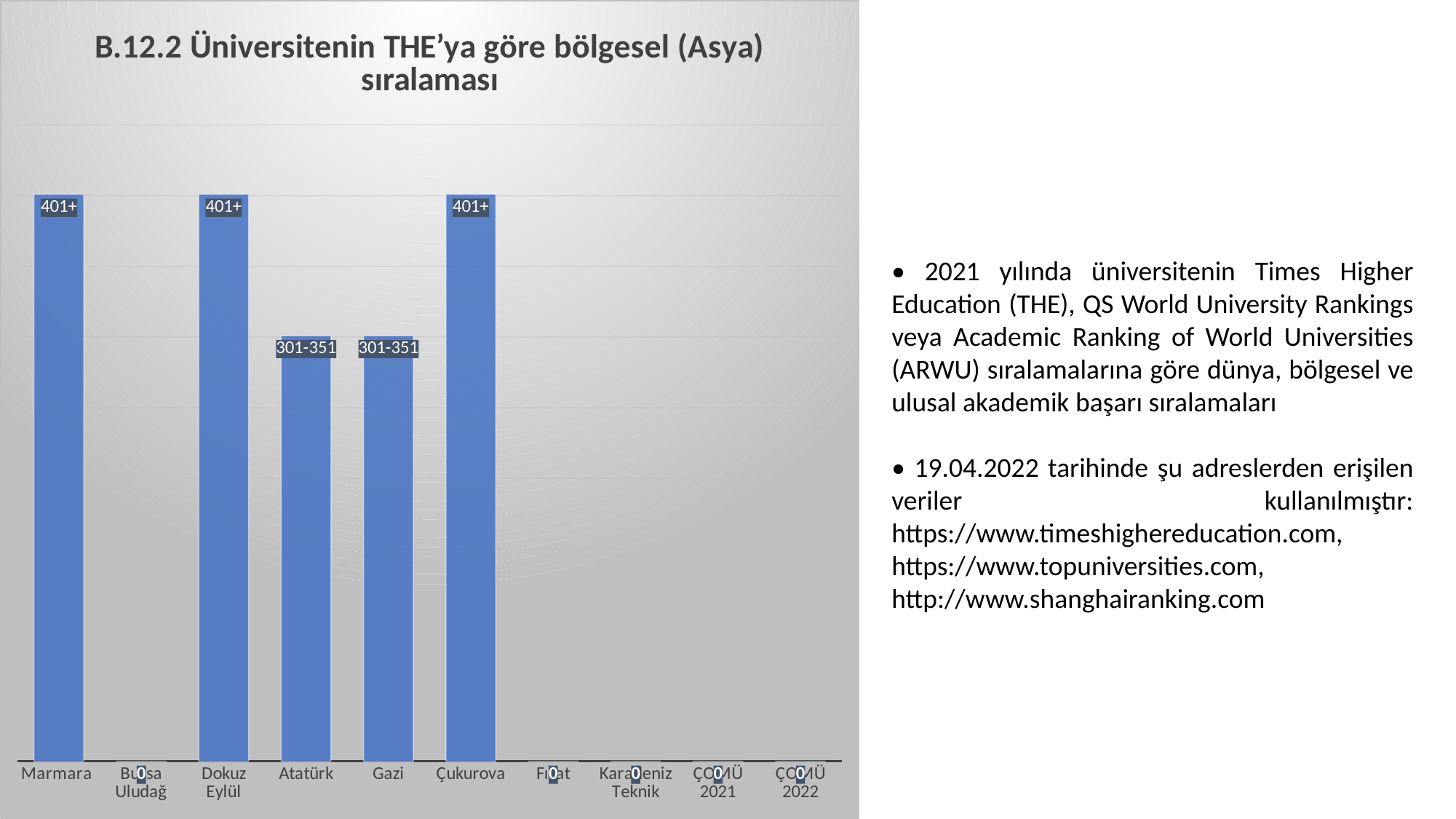
What is the data label shown for Gazi? 301-351 What is the data label shown for Atatürk? 301-351 What is the title of the chart? B.12.2 Üniversitenin THE'ya göre bölgesel (Asya) sıralaması What is the data label shown for ÇOMÜ 2022? 0 What is the data label shown for Çukurova? 401+ Which bar is taller, Marmara or Atatürk? Marmara What is the data label shown for Marmara? 401+ What colour are the bars in the chart? blue How many categories are shown on the x axis of the chart? 10 What is the data label shown for Dokuz Eylül? 401+ What is the data label shown for Bursa Uludağ? 0 What kind of chart is shown on the slide? bar chart